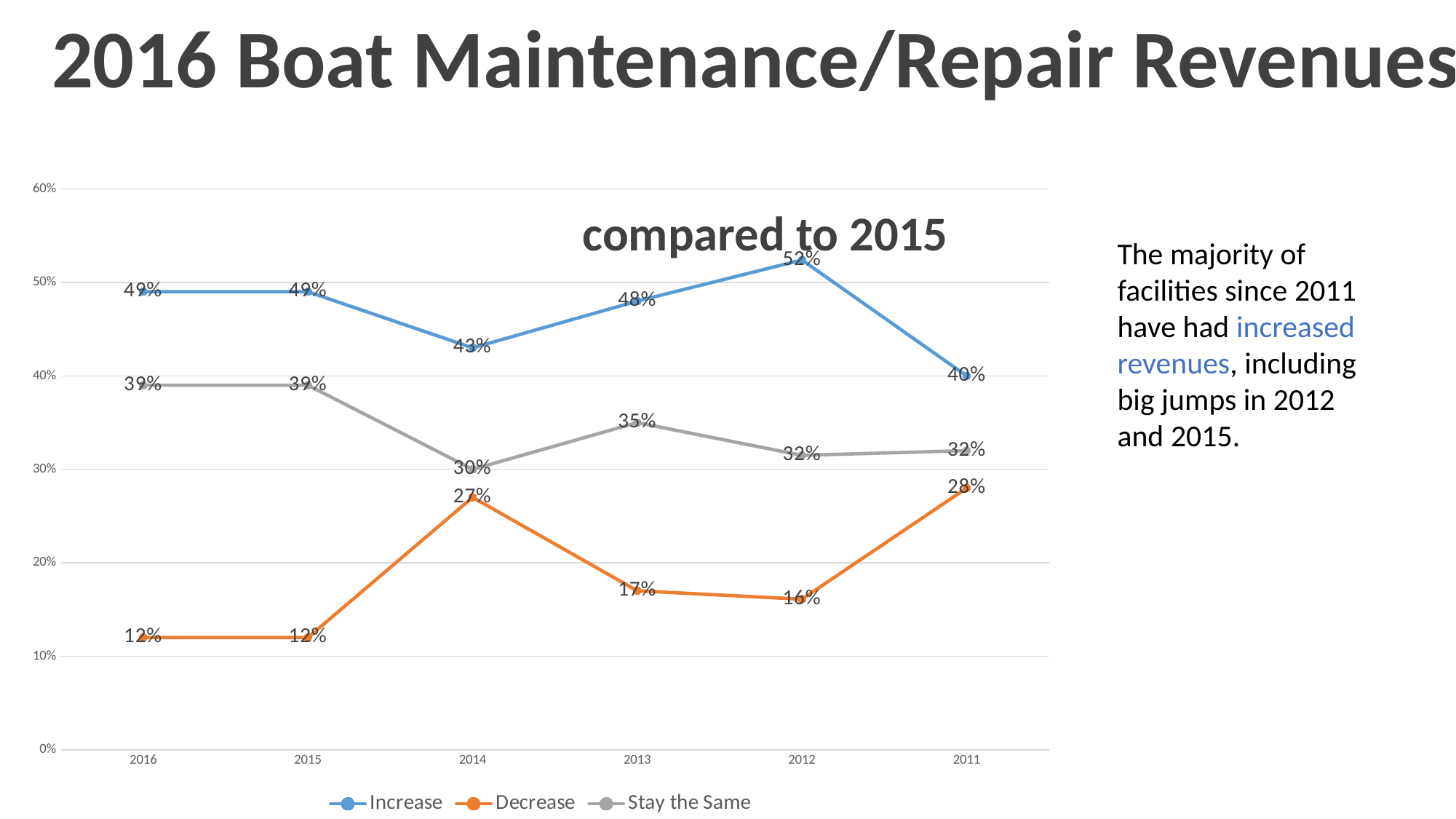
Which is larger in 2014: the Decrease value or the Stay the Same value? Stay the Same What type of chart is shown on the slide? Line chart What is the difference between the Increase and Decrease values in 2011? 12% How many years are plotted along the x axis? 6 What is the value for Decrease in 2014? 27% In which year is the Increase series at its highest? 2012 What is the value for Increase in 2012? 52% Which series is shown in orange in the legend? Decrease How many series does the legend list? 3 In which year is the Increase series at its lowest? 2011 What is the value for Stay the Same in 2013? 35% Is the value for Decrease in 2013 greater or less than 20%? less